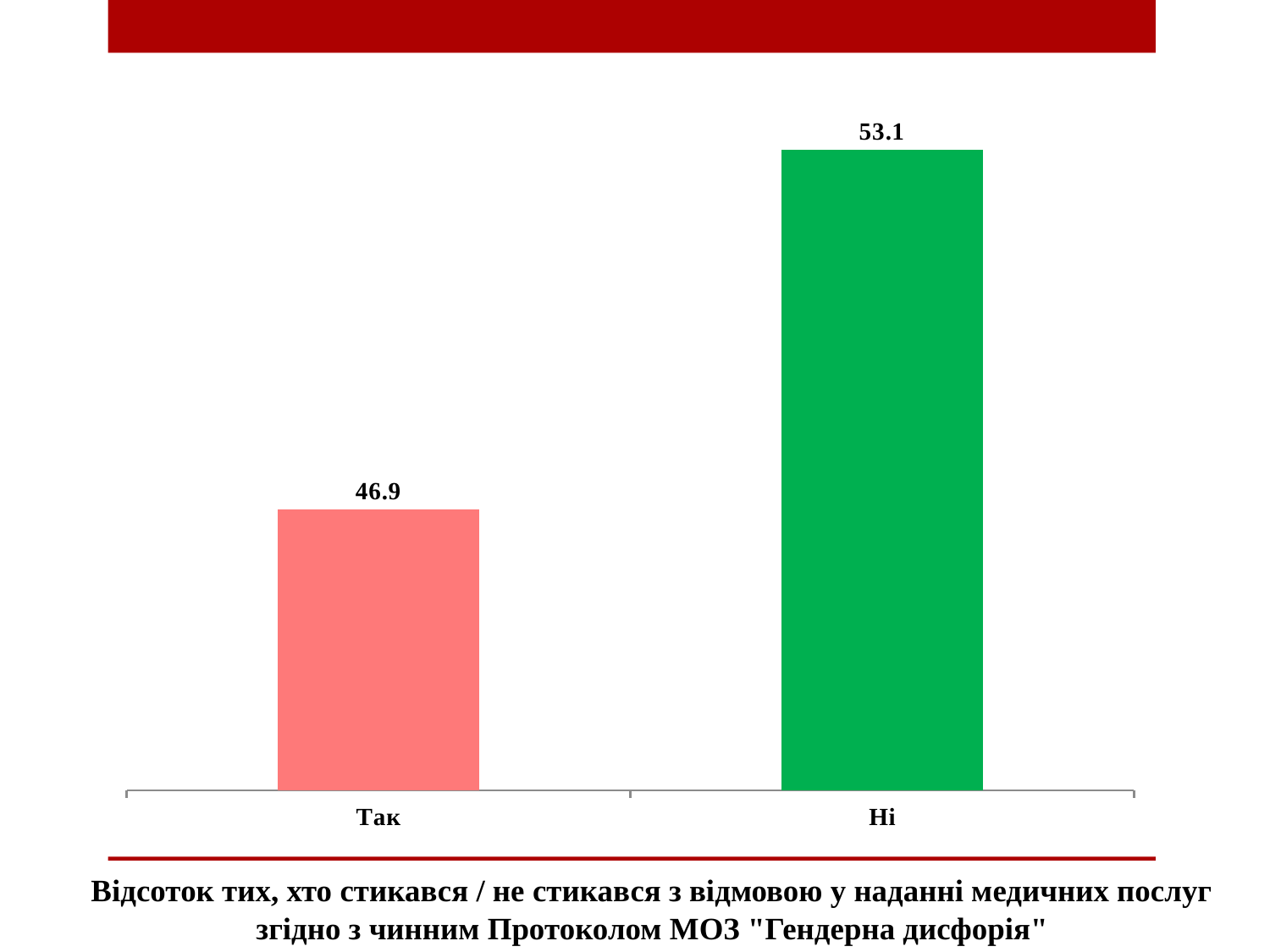
What is the total of the two values shown in the chart? 100 What colour is the bar for "Ні"? Green What colour is the bar for "Так"? Pink (light red) Which category has the lowest value? Так What kind of chart is shown on the slide? Bar chart How many categories are shown in the chart? 2 What is the difference between the values for "Ні" and "Так"? 6.2 What is the value for "Ні"? 53.1 What is the value for "Так"? 46.9 Which category has the highest value? Ні Which is larger, the value for "Так" or the value for "Ні"? Ні